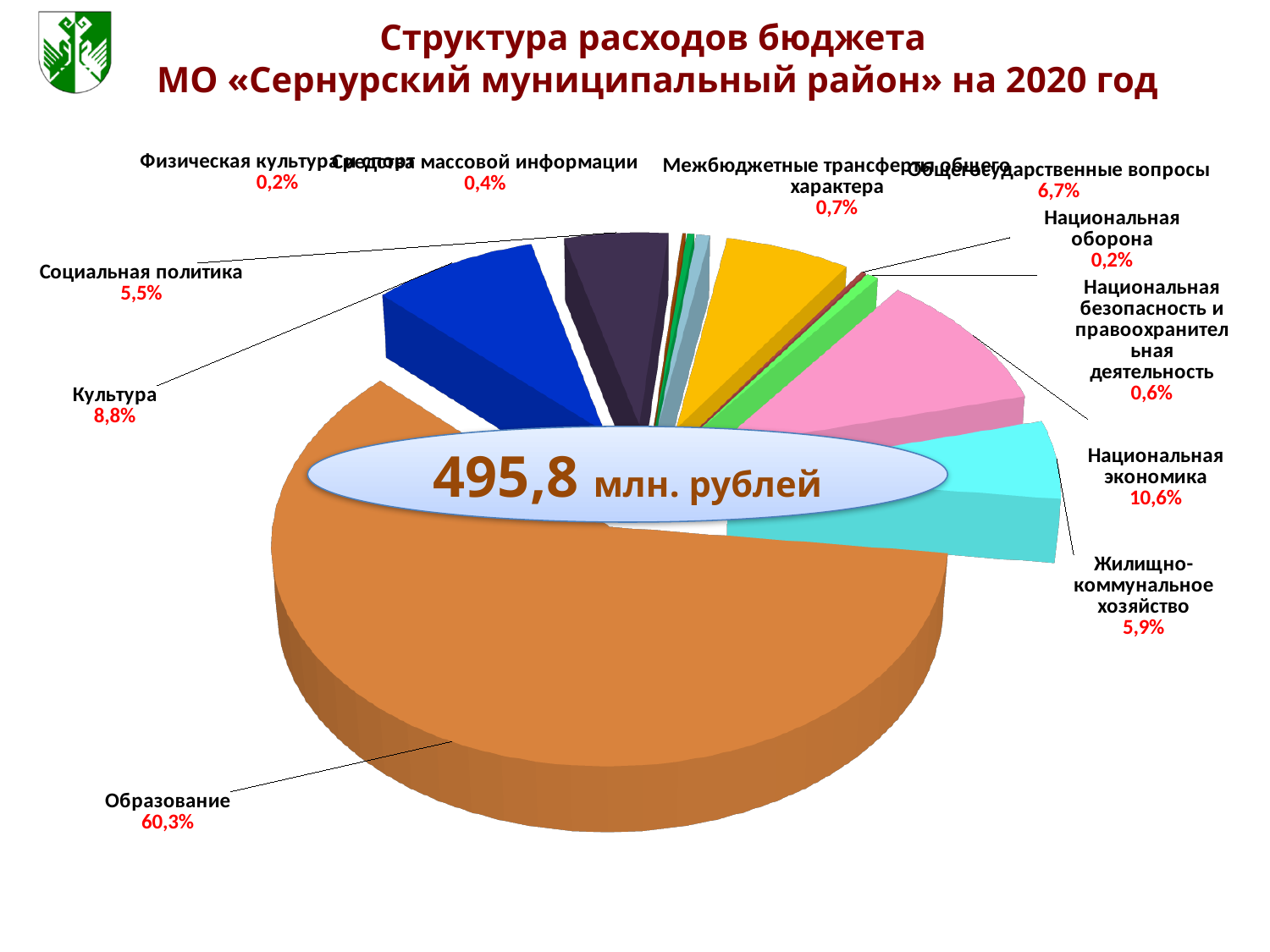
Which is larger, the share for Культура or the share for Социальная политика? Культура Which category has the largest share of the budget expenditure? Образование What share of expenditure goes to Национальная безопасность и правоохранительная деятельность? 0,6% What share of expenditure goes to Национальная экономика? 10,6% For which year does the chart show the budget expenditure structure? 2020 What share of expenditure goes to Образование? 60,3% What share of expenditure goes to Жилищно-коммунальное хозяйство? 5,9% What kind of chart is shown on the slide? Pie chart What share of expenditure goes to Социальная политика? 5,5% What is the difference in percentage points between the shares for Национальная экономика and Культура? 1,8 What total amount of budget expenditure is shown in the centre of the chart? 495,8 млн. рублей What share of expenditure goes to Культура? 8,8%